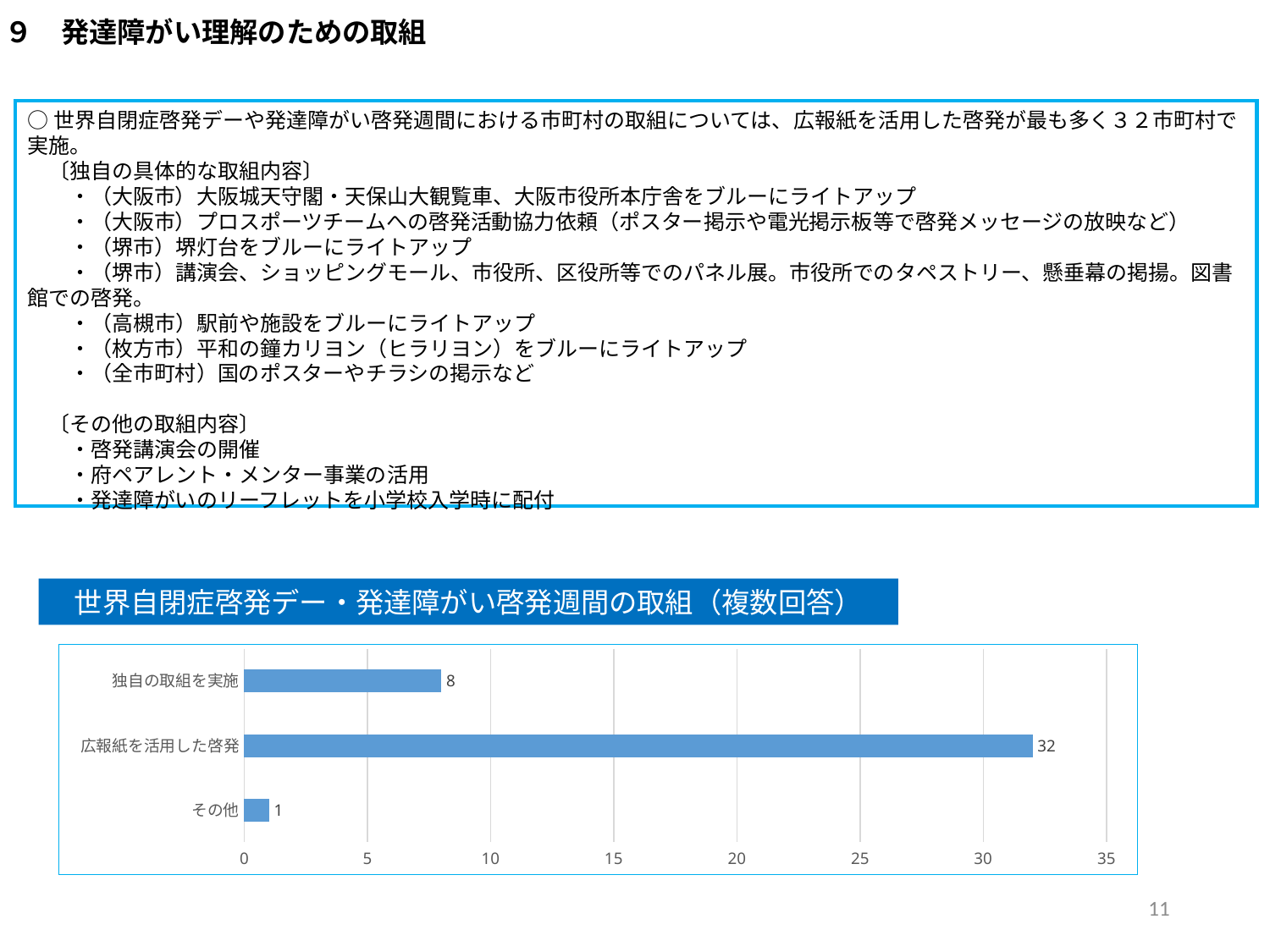
What is the value for その他? 1 Which category has the lowest value? その他 Which category has the highest value? 広報紙を活用した啓発 What kind of chart is shown on the slide? bar chart Is the value for 広報紙を活用した啓発 greater or less than 30? greater What is the maximum value shown on the x axis of the chart? 35 Which is larger, the value for 独自の取組を実施 or the value for その他? 独自の取組を実施 What is the value for 独自の取組を実施? 8 What is the value for 広報紙を活用した啓発? 32 What is the title of the chart? 世界自閉症啓発デー・発達障がい啓発週間の取組（複数回答） How many categories are shown in the chart? 3 What is the difference between the values for 広報紙を活用した啓発 and 独自の取組を実施? 24